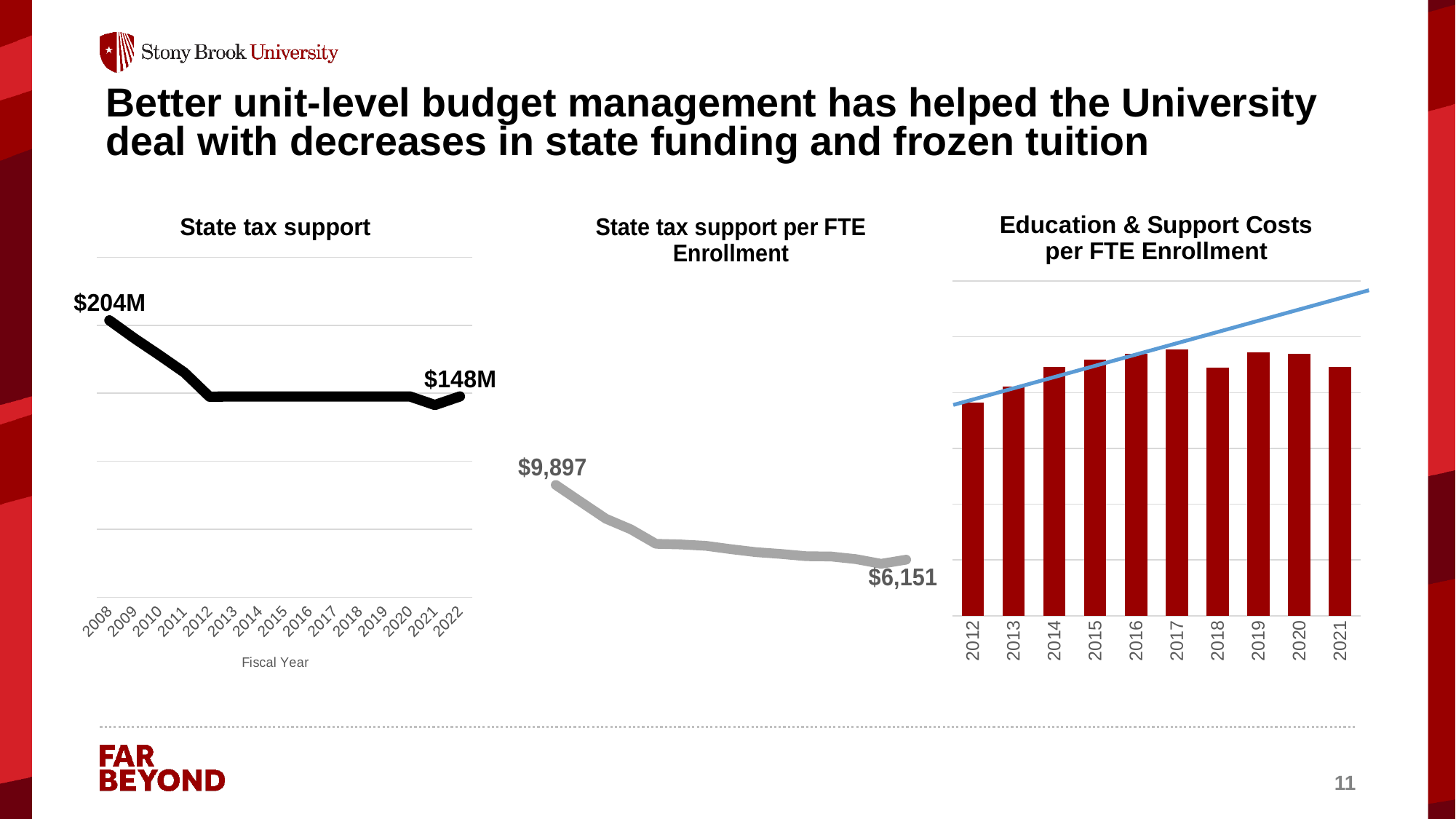
In the Education & Support Costs per FTE Enrollment chart, which year has the lowest bar? 2012 What is the x-axis title of the State tax support chart? Fiscal Year How many bars are in the Education & Support Costs per FTE Enrollment chart? 10 In the State tax support chart, what is the difference between the 2008 value and the 2022 value? $56M In the State tax support per FTE Enrollment chart, what is the value labelled at the last point of the line? $6,151 In the State tax support chart, what is the value labelled for fiscal year 2022? $148M In the State tax support per FTE Enrollment chart, what is the difference between the first labelled value and the last labelled value? $3,746 What kind of chart is the Education & Support Costs per FTE Enrollment chart? bar chart In the State tax support chart, do the values rise or fall from 2008 to 2022? fall In the State tax support chart, what is the value labelled for fiscal year 2008? $204M How many fiscal years are shown on the x axis of the State tax support chart? 15 In the State tax support per FTE Enrollment chart, what is the value labelled at the first point of the line? $9,897